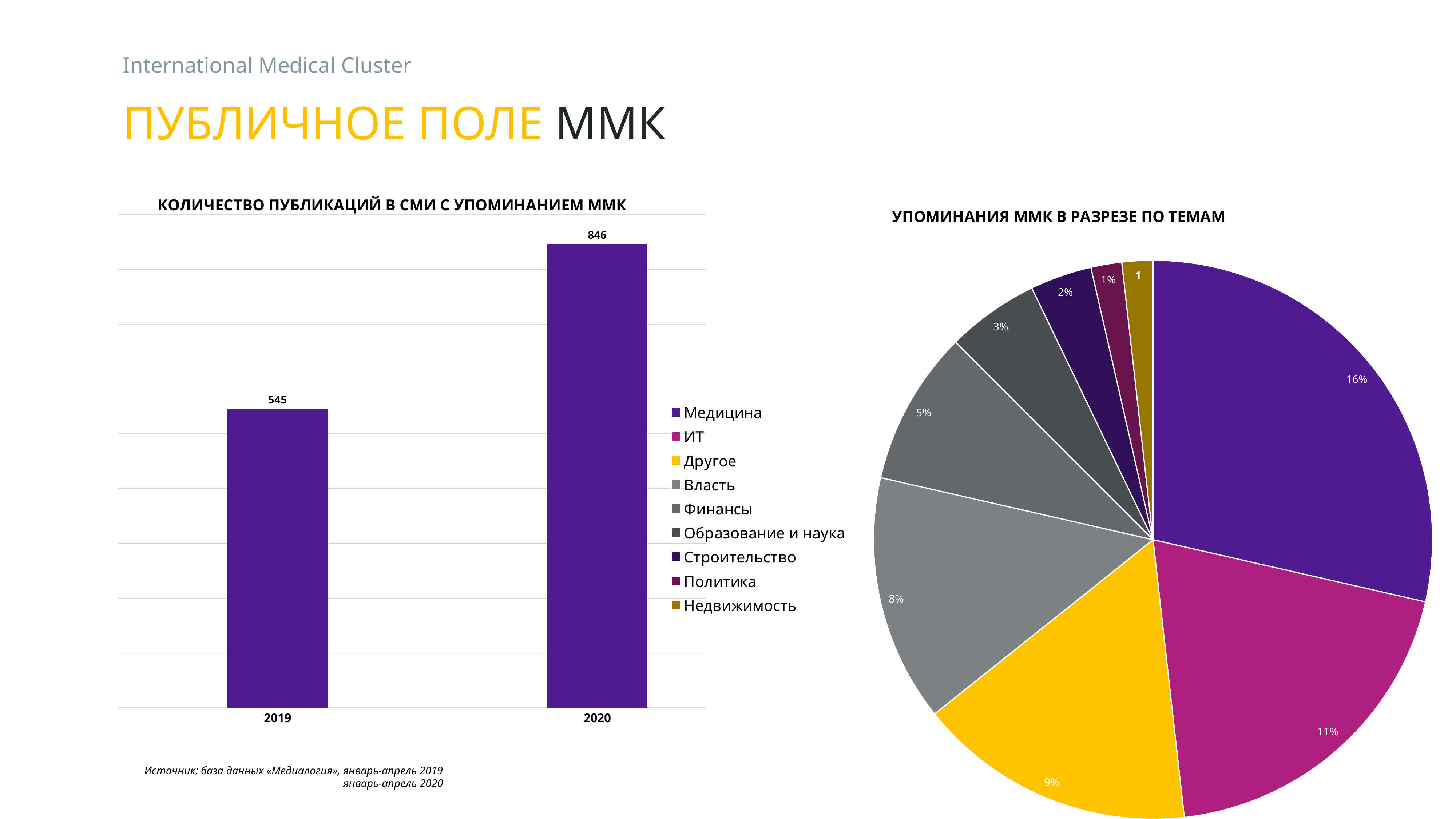
In the chart 'УПОМИНАНИЯ ММК В РАЗРЕЗЕ ПО ТЕМАМ', what share does Медицина have? 16% What kind of chart is 'УПОМИНАНИЯ ММК В РАЗРЕЗЕ ПО ТЕМАМ'? pie chart In the chart 'УПОМИНАНИЯ ММК В РАЗРЕЗЕ ПО ТЕМАМ', which topic has the largest slice? Медицина In the chart 'УПОМИНАНИЯ ММК В РАЗРЕЗЕ ПО ТЕМАМ', what share does ИТ have? 11% In the chart 'КОЛИЧЕСТВО ПУБЛИКАЦИЙ В СМИ С УПОМИНАНИЕМ ММК', what is the value for 2019? 545 In the chart 'УПОМИНАНИЯ ММК В РАЗРЕЗЕ ПО ТЕМАМ', which is larger: Другое or Власть? Другое In the chart 'КОЛИЧЕСТВО ПУБЛИКАЦИЙ В СМИ С УПОМИНАНИЕМ ММК', which year has the higher value? 2020 What kind of chart is 'КОЛИЧЕСТВО ПУБЛИКАЦИЙ В СМИ С УПОМИНАНИЕМ ММК'? bar chart In the chart 'КОЛИЧЕСТВО ПУБЛИКАЦИЙ В СМИ С УПОМИНАНИЕМ ММК', what is the difference between the 2020 and 2019 values? 301 In the chart 'КОЛИЧЕСТВО ПУБЛИКАЦИЙ В СМИ С УПОМИНАНИЕМ ММК', what is the value for 2020? 846 How many entries does the legend of the chart 'УПОМИНАНИЯ ММК В РАЗРЕЗЕ ПО ТЕМАМ' list? 9 In the chart 'КОЛИЧЕСТВО ПУБЛИКАЦИЙ В СМИ С УПОМИНАНИЕМ ММК', do the values rise or fall from 2019 to 2020? rise